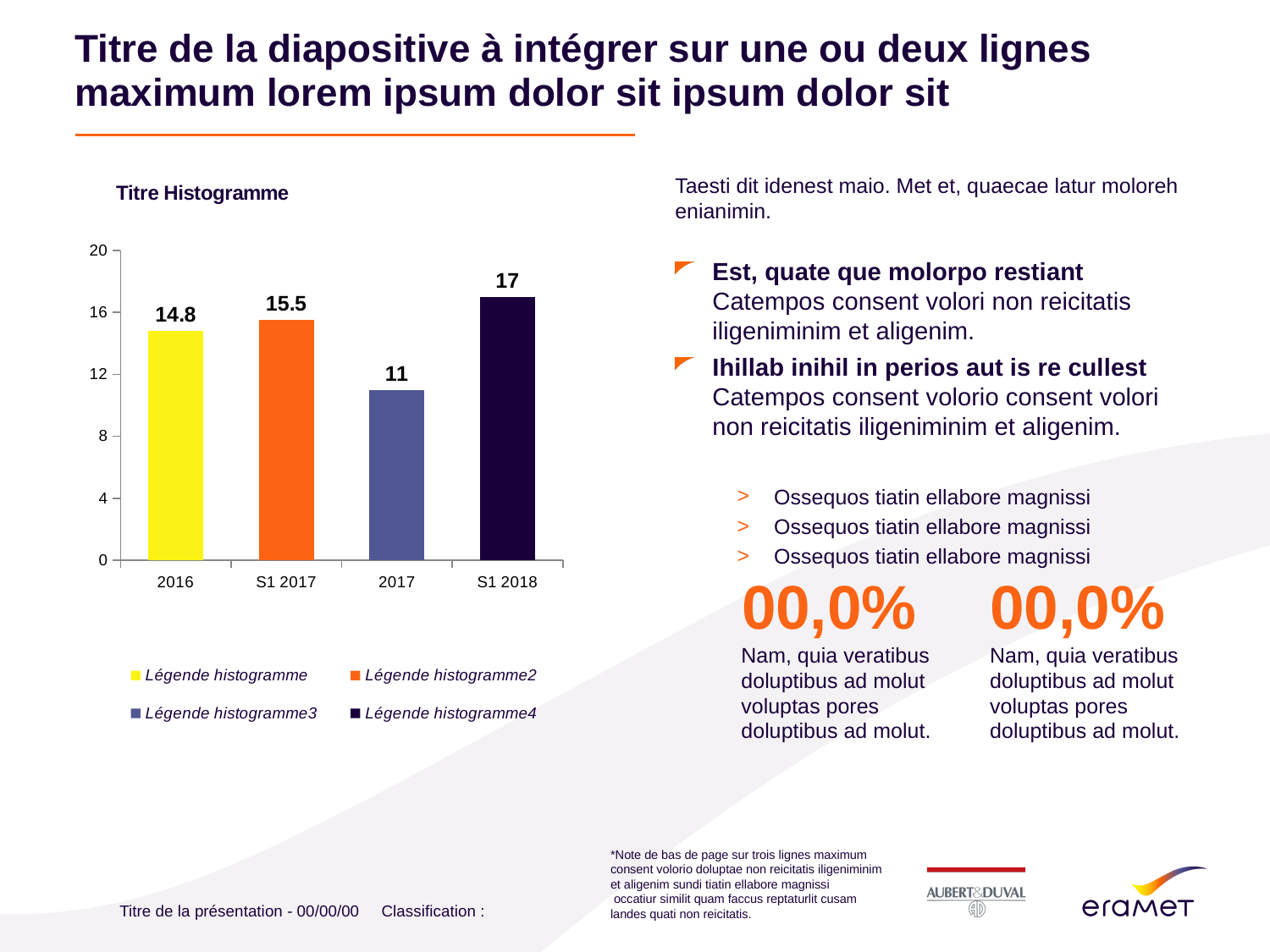
What is the value for S1 2017 in the Titre Histogramme chart? 15.5 Which category has the highest value in the Titre Histogramme chart? S1 2018 How many categories are shown on the x axis of the Titre Histogramme chart? 4 Which category has the lowest value in the Titre Histogramme chart? 2017 How many entries does the legend of the Titre Histogramme chart list? 4 What kind of chart is the Titre Histogramme chart? bar chart Is the value for 2017 in the Titre Histogramme chart greater or less than 12? less What is the value for S1 2018 in the Titre Histogramme chart? 17 What is the value for 2016 in the Titre Histogramme chart? 14.8 What is the value for 2017 in the Titre Histogramme chart? 11 What is the difference between the values for S1 2018 and 2017 in the Titre Histogramme chart? 6 Which is larger in the Titre Histogramme chart, the value for 2016 or the value for S1 2017? S1 2017